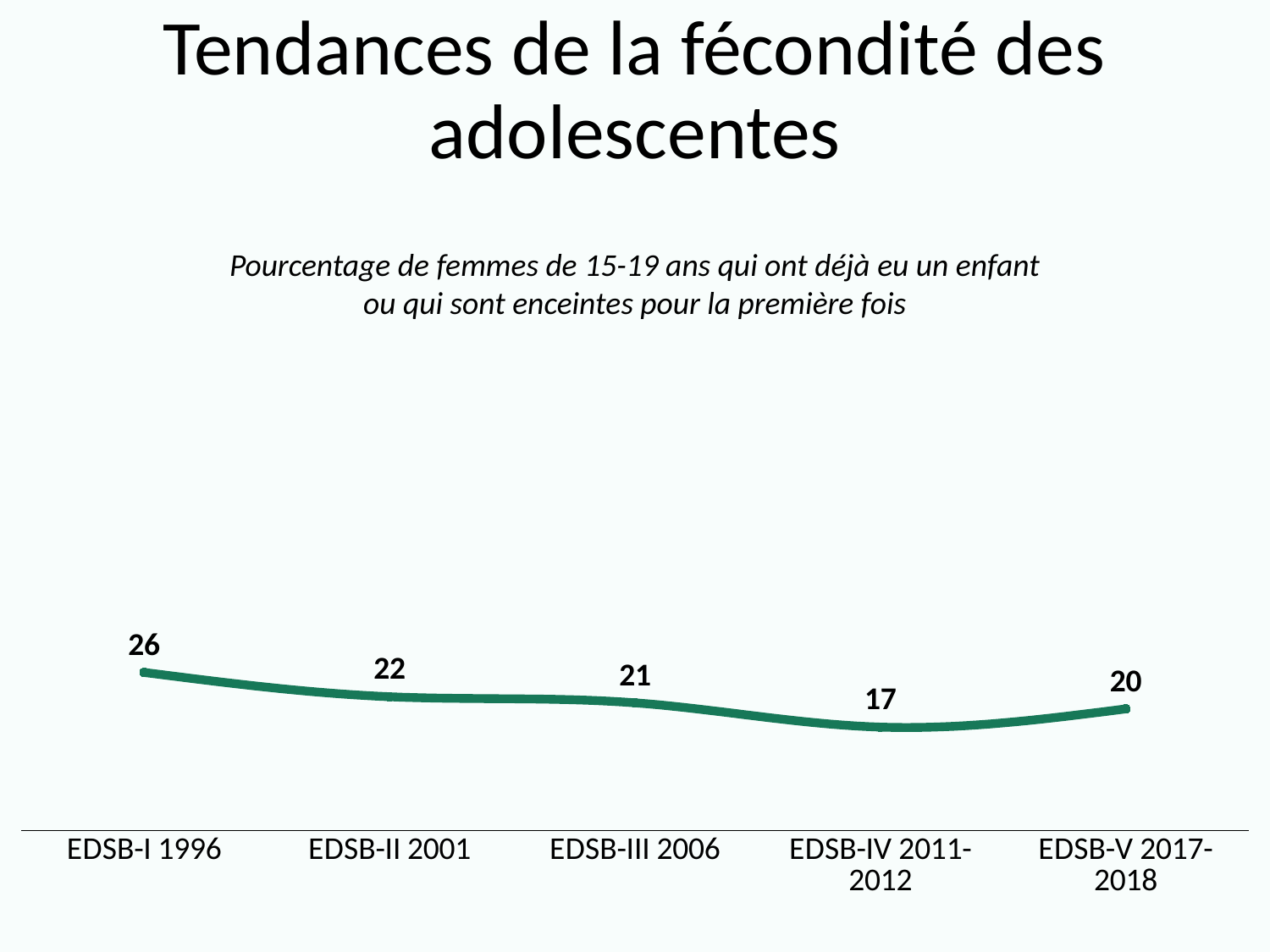
Which survey has the lowest value? EDSB-IV 2011-2012 What kind of chart is shown on the slide? Line chart What is the value for EDSB-V 2017-2018? 20 What is the difference between the values for EDSB-I 1996 and EDSB-IV 2011-2012? 9 Which is larger, the value for EDSB-II 2001 or the value for EDSB-V 2017-2018? EDSB-II 2001 What is the value for EDSB-IV 2011-2012? 17 Does the value rise or fall from EDSB-I 1996 to EDSB-IV 2011-2012? Fall How many data points are plotted on the chart? 5 What is the value for EDSB-II 2001? 22 What is the value for EDSB-I 1996? 26 Which survey has the highest value? EDSB-I 1996 What is the value for EDSB-III 2006? 21